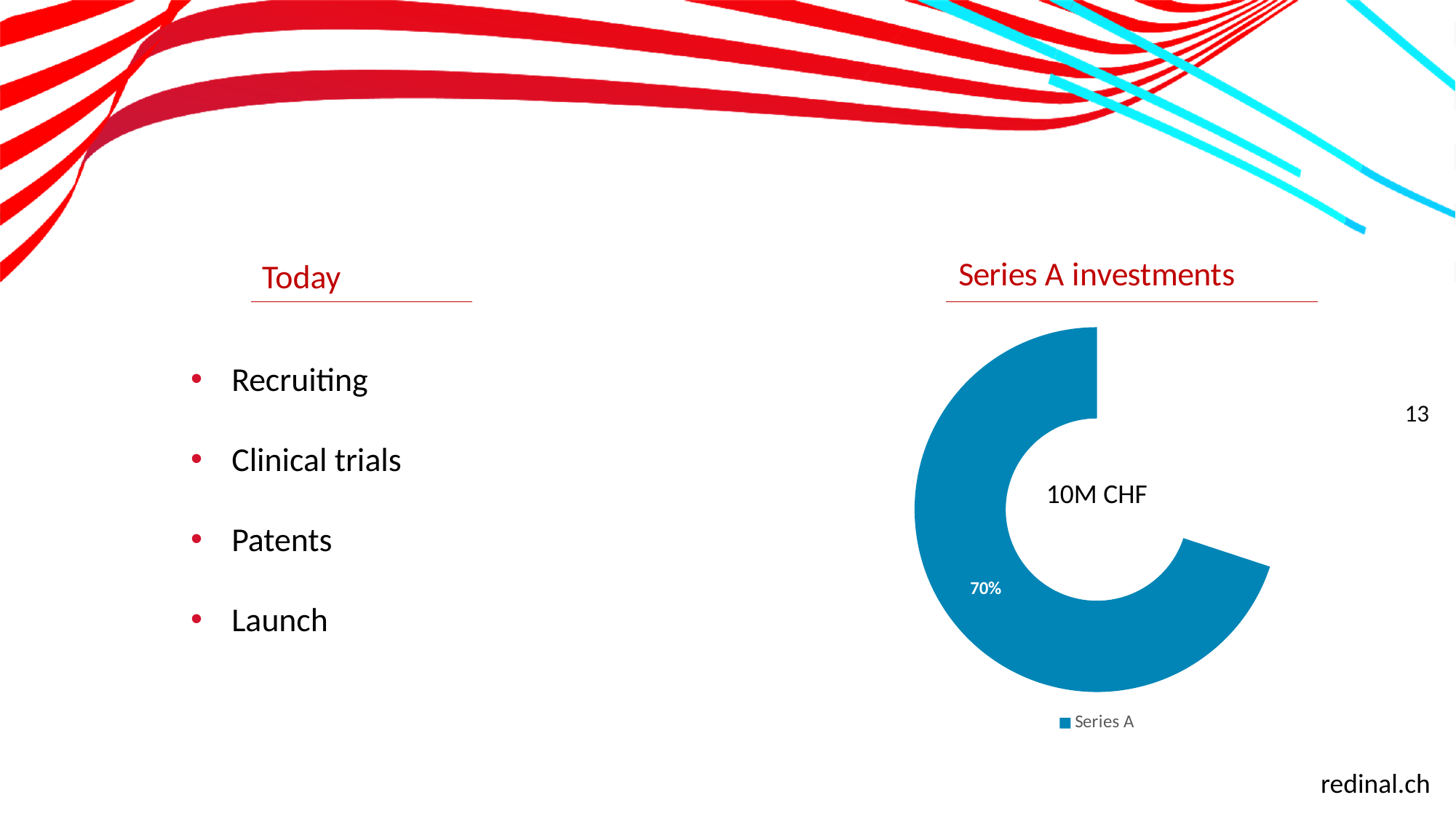
What percentage is printed on the blue slice of the doughnut chart? 70% Is the value shown on the blue slice of the doughnut chart greater or less than 50%? greater What is the title above the doughnut chart? Series A investments What is the name of the series listed in the legend of the doughnut chart? Series A What share of the doughnut chart does the blue slice represent? 70% What text is printed in the centre of the doughnut chart? 10M CHF How many entries does the legend of the doughnut chart list? 1 How many slices of the doughnut chart carry a percentage label? 1 What kind of chart is shown under the heading "Series A investments"? doughnut chart